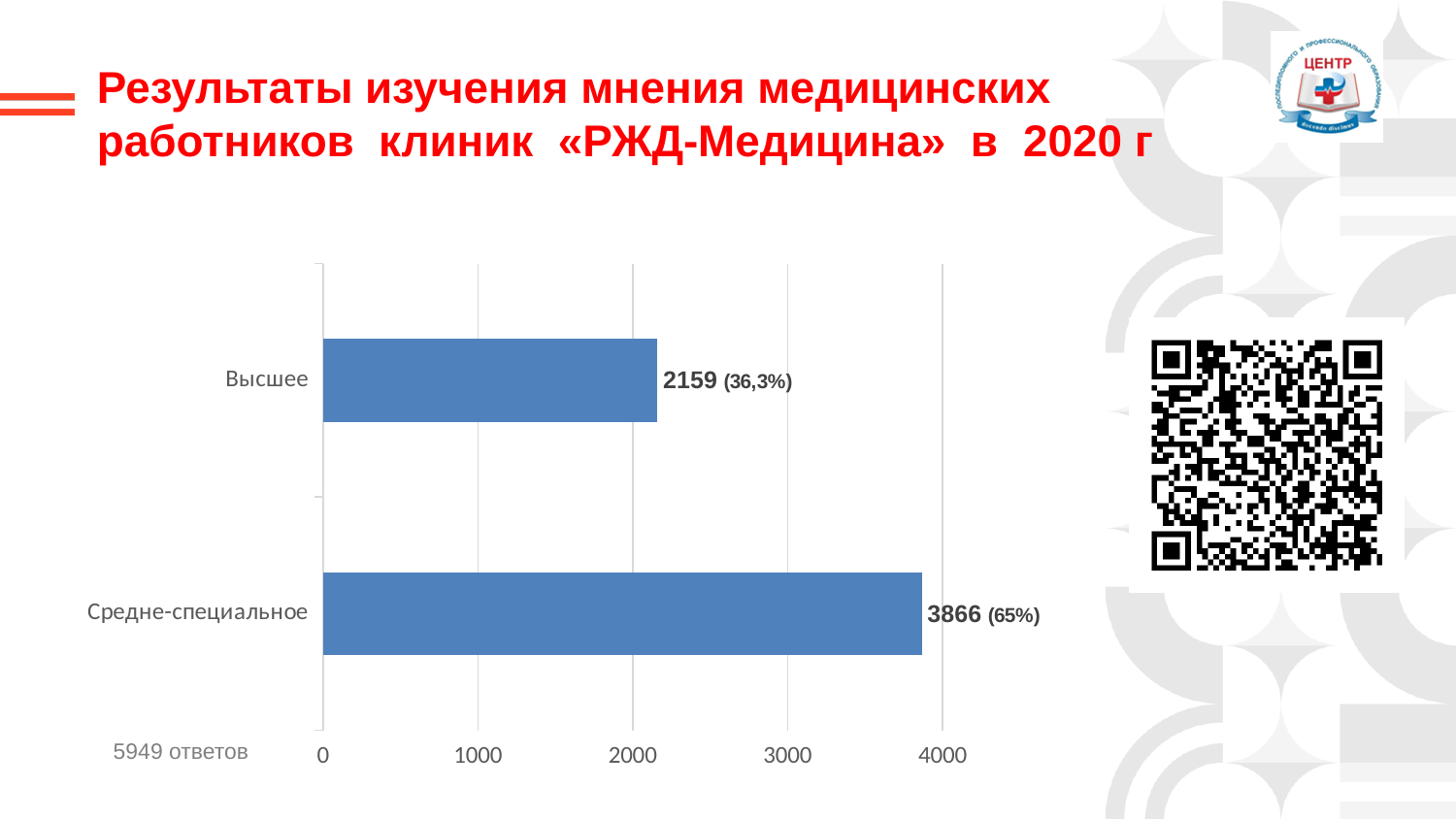
Which is larger, the value for Высшее or the value for Средне-специальное? Средне-специальное What kind of chart is shown on the slide? bar chart Which category has the highest value? Средне-специальное What percentage is shown next to the Высшее bar? 36,3% What is the value for Средне-специальное? 3866 How many categories are shown in the chart? 2 Which category has the lowest value? Высшее What is the value for Высшее? 2159 What is the highest value shown on the horizontal axis? 4000 What is the difference between the values for Средне-специальное and Высшее? 1707 What percentage is shown next to the Средне-специальное bar? 65% Is the value for Высшее greater or less than 2000? greater